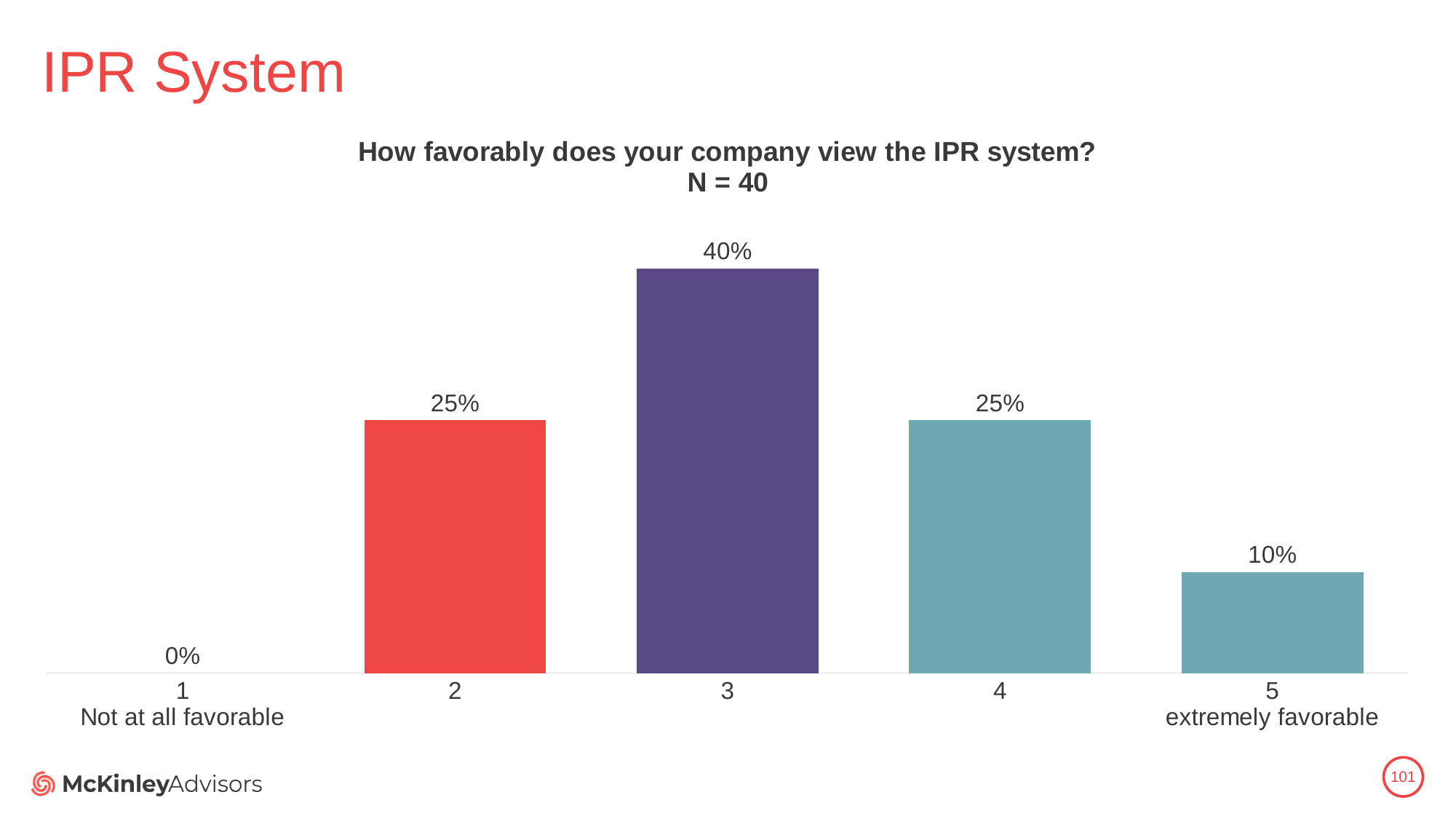
Which rating received the lowest percentage of responses? 1 What is the difference in percentage points between rating 3 and rating 4? 15 Which rating received the highest percentage of responses? 3 What type of chart is shown on the slide? Bar chart What percentage of respondents rated the IPR system a 1 (Not at all favorable)? 0% What is the sample size (N) stated in the chart title? 40 What is the combined percentage for ratings 4 and 5? 35% What percentage of respondents rated the IPR system a 5 (extremely favorable)? 10% What percentage of respondents rated the IPR system a 3? 40% What is the difference in percentage points between rating 2 and rating 5? 15 Which rating has a larger share of responses, 4 or 5? 4 How many rating categories are shown on the x axis? 5